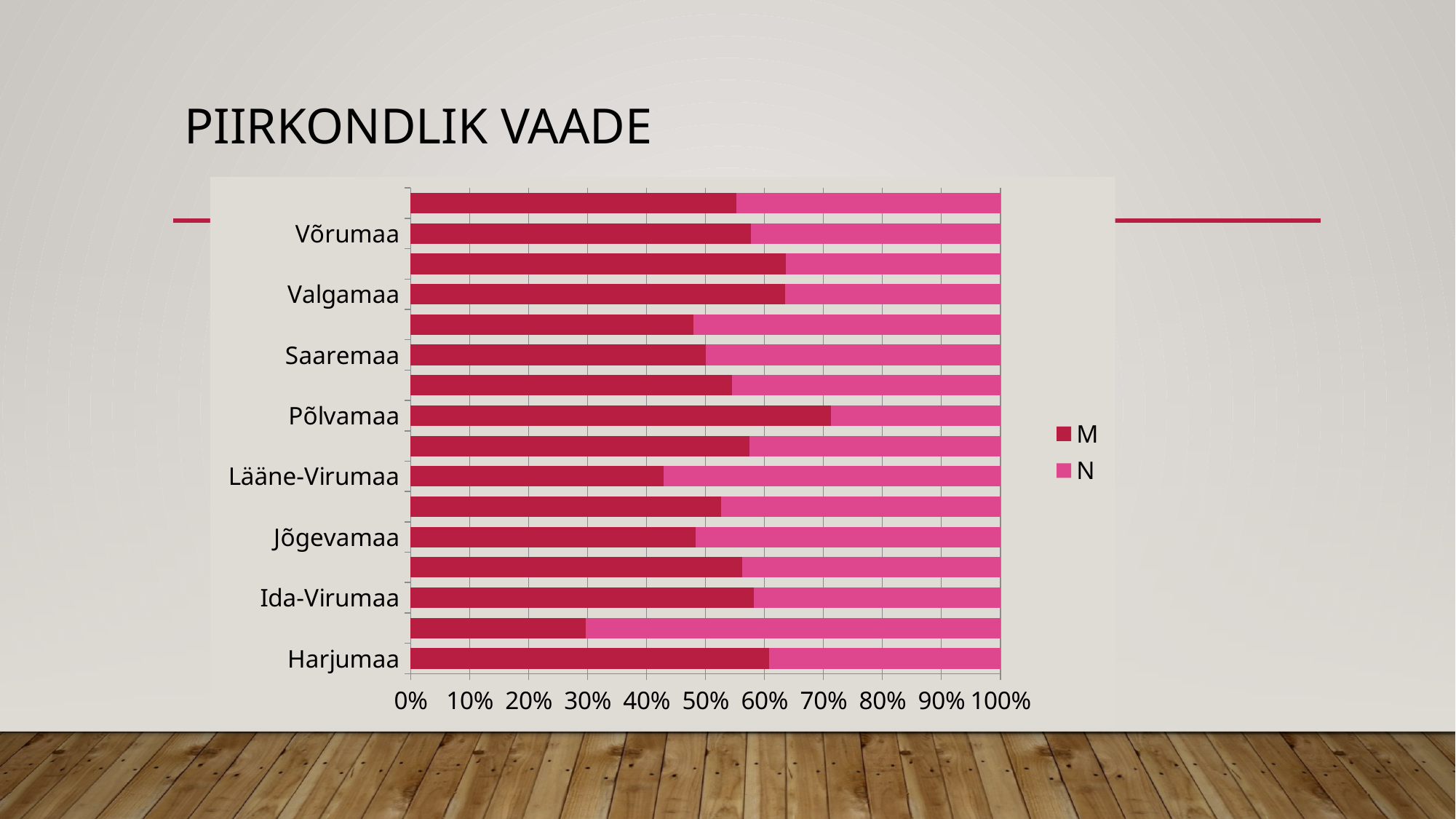
Is the M share for Lääne-Virumaa greater or less than 50%? less How many series does the legend list? 2 Is the M share for Ida-Virumaa greater or less than 50%? greater What kind of chart is shown on the slide? bar chart What are the two series named in the legend? M and N Is the M share for Harjumaa greater or less than 50%? greater Which has the larger N share, Lääne-Virumaa or Harjumaa? Lääne-Virumaa What is the title of the slide containing the chart? Piirkondlik vaade Which has the larger M share, Põlvamaa or Lääne-Virumaa? Põlvamaa Among the labelled counties, which has the highest M share? Põlvamaa